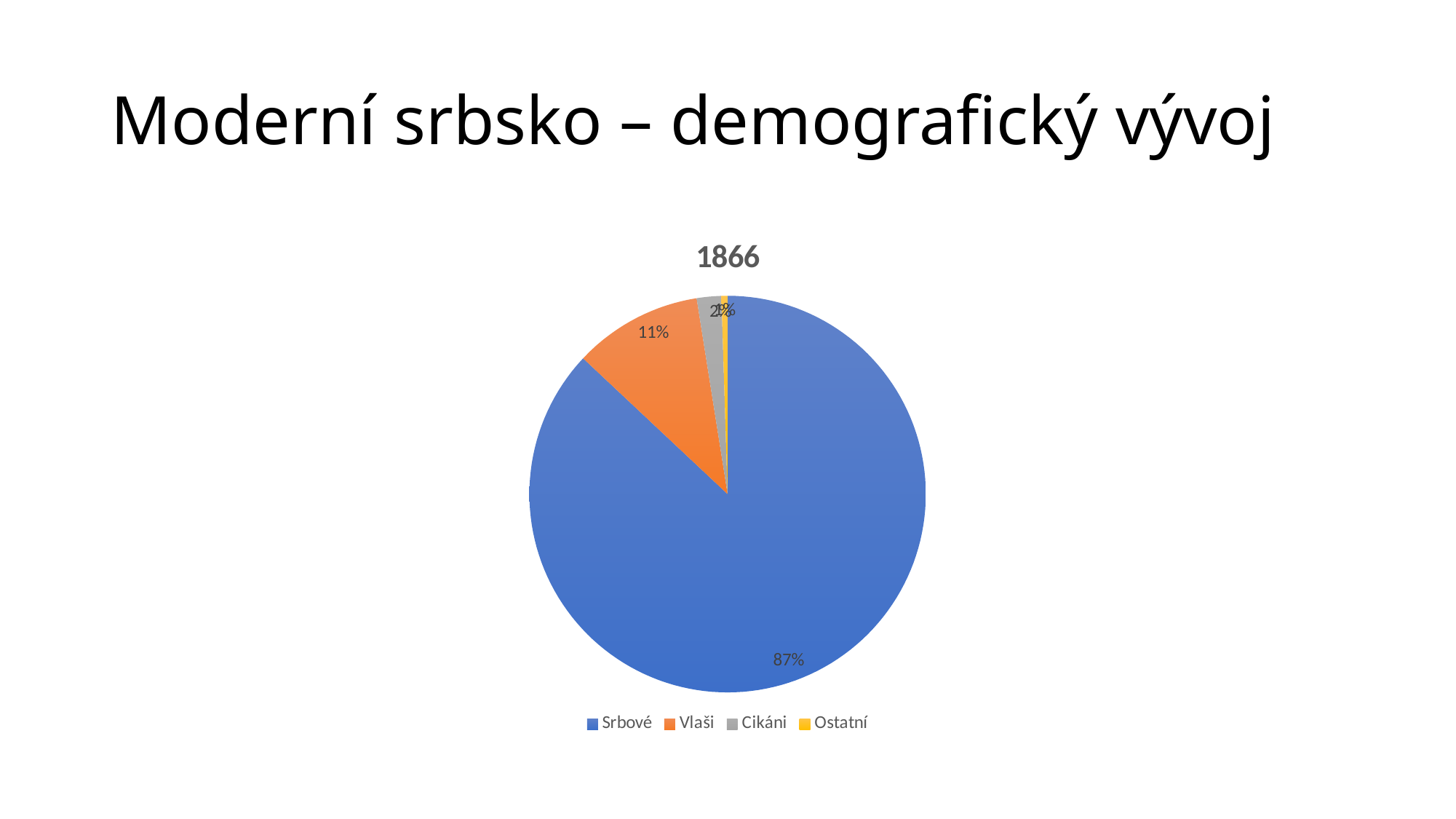
What is the difference in percentage points between Srbové and Vlaši? 76 What percentage is shown for Vlaši? 11% Which category has the smallest slice of the pie? Ostatní Which is larger, the slice for Vlaši or the slice for Cikáni? Vlaši What colour is the Srbové slice? Blue Which category has the largest slice of the pie? Srbové What is the difference in percentage points between Vlaši and Cikáni? 9 What share of the pie does Srbové hold? 87% What percentage is shown for Cikáni? 2% What kind of chart is shown on the slide? Pie chart What is the title of the chart? 1866 How many categories does the pie chart show? 4